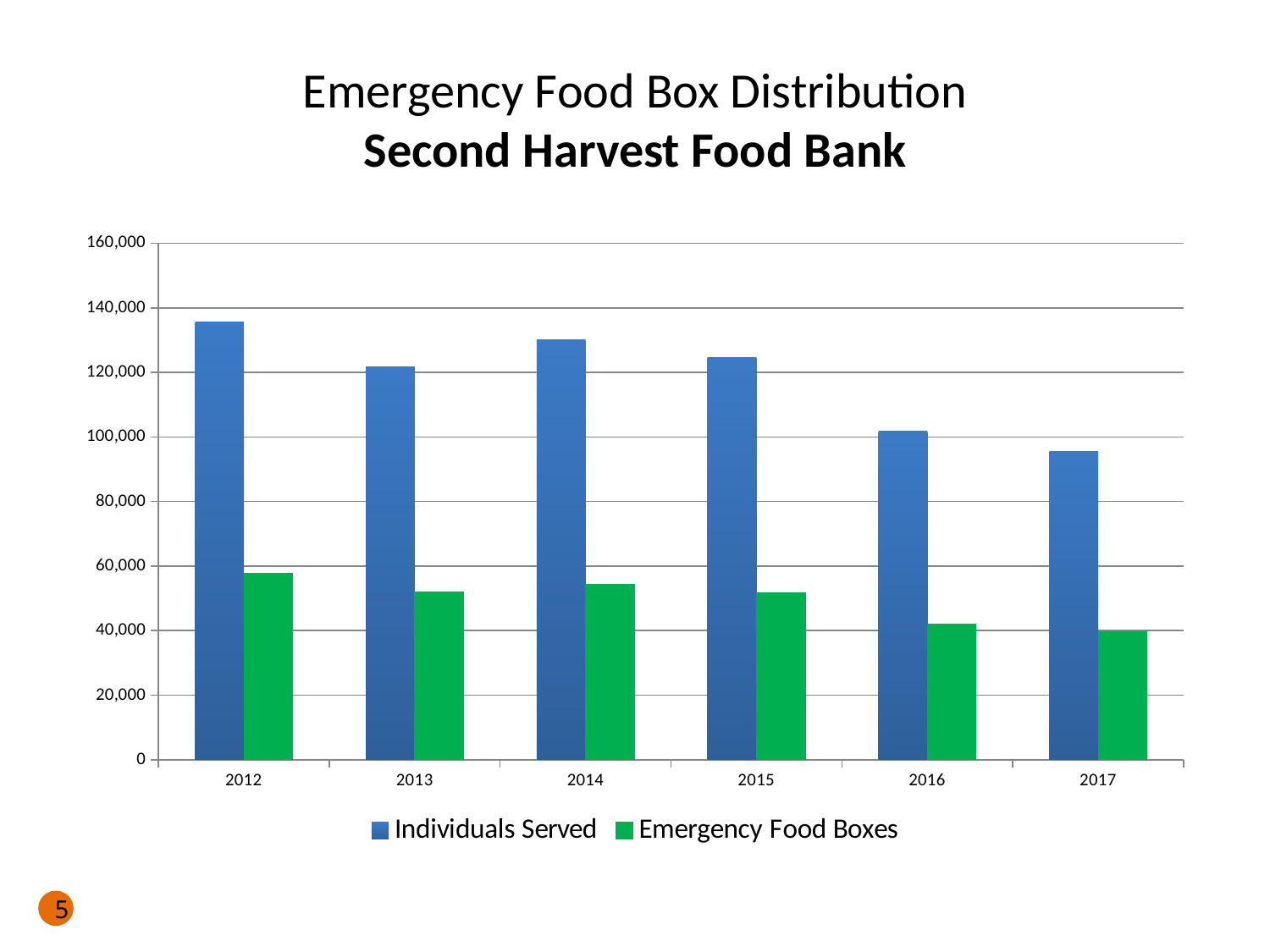
Is the value for Individuals Served in 2012 greater or less than 140,000? less Which colour represents Emergency Food Boxes in the legend? Green In which year was the number of Individuals Served lowest? 2017 Is the value for Individuals Served in 2017 greater or less than 100,000? less How many series does the legend list? 2 What kind of chart is shown on the slide? Bar chart Is the value for Emergency Food Boxes in 2013 greater or less than 40,000? greater In which year was the number of Individuals Served highest? 2012 Overall, do the Emergency Food Boxes values rise or fall from 2012 to 2017? Fall How many years are shown on the x axis? 6 Which year had more Individuals Served, 2013 or 2014? 2014 In which year was the number of Emergency Food Boxes highest? 2012